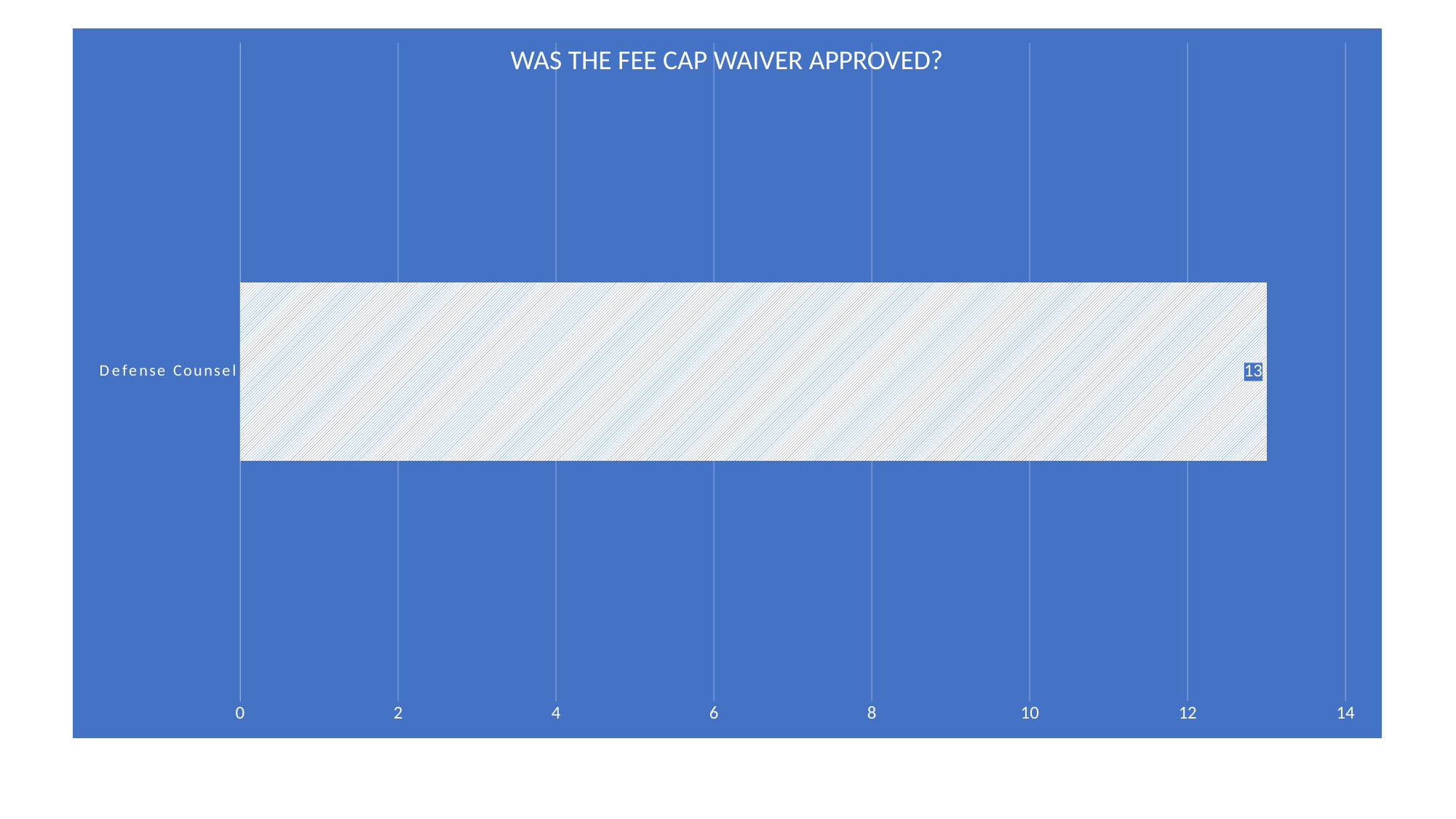
What is the title of the chart? WAS THE FEE CAP WAIVER APPROVED? Is the value for Defense Counsel greater or less than 12? greater What is the value for Defense Counsel? 13 How many categories are plotted in the chart? 1 Which category has the highest value in the chart? Defense Counsel What kind of chart is shown on the slide? bar chart What is the maximum value shown on the horizontal axis? 14 Is the value for Defense Counsel greater or less than 14? less